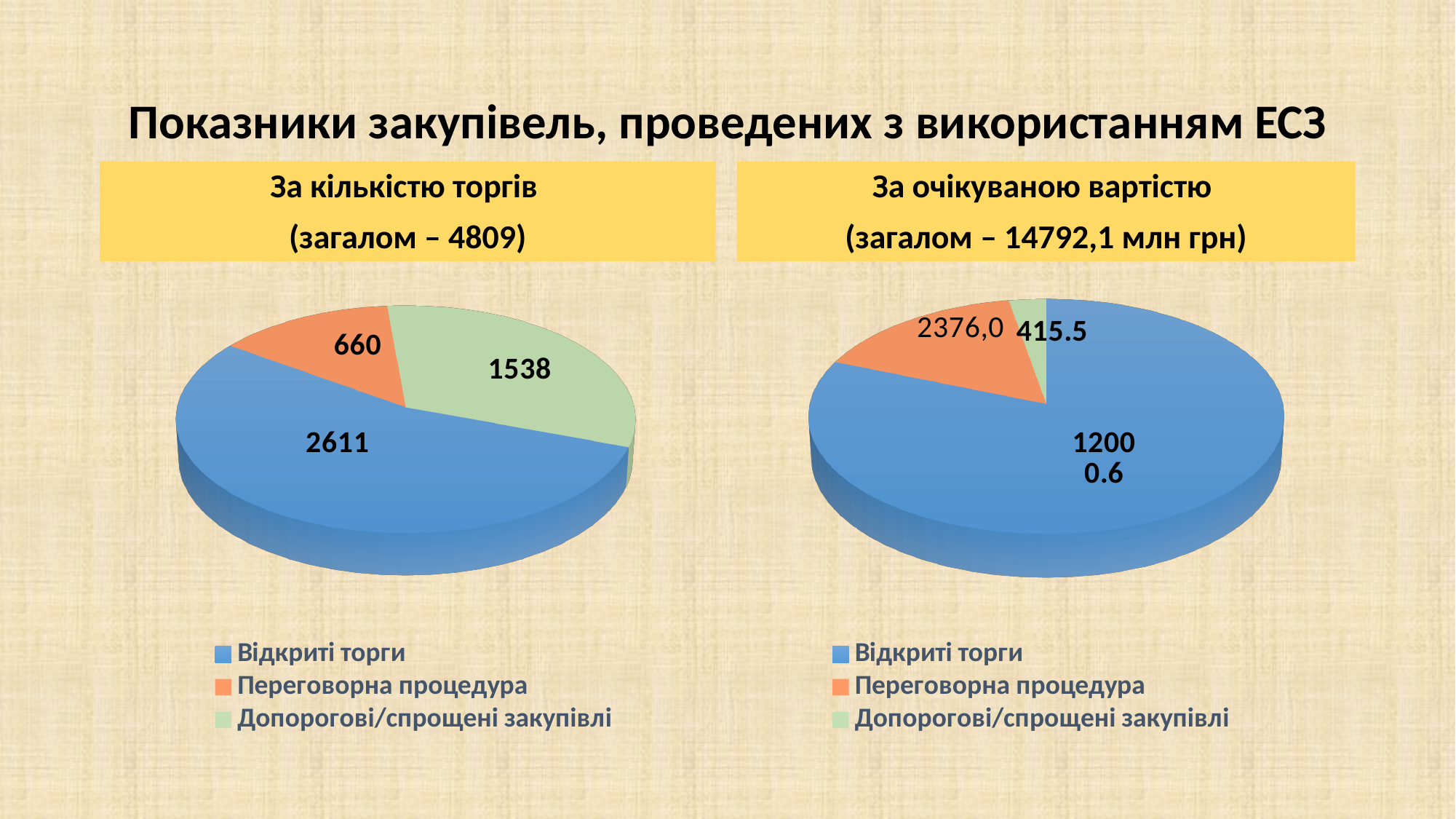
In the left chart 'За кількістю торгів', which category has the smallest slice? Переговорна процедура In the left chart 'За кількістю торгів', what is the value for 'Переговорна процедура'? 660 In the left chart 'За кількістю торгів', which category has the largest slice? Відкриті торги In the right chart 'За очікуваною вартістю', which category has the largest slice? Відкриті торги In the right chart 'За очікуваною вартістю', what is the value for 'Допорогові/спрощені закупівлі'? 415.5 In the left chart 'За кількістю торгів', what is the difference between 'Відкриті торги' and 'Допорогові/спрощені закупівлі'? 1073 In the right chart 'За очікуваною вартістю', which is larger: 'Переговорна процедура' or 'Допорогові/спрощені закупівлі'? Переговорна процедура In the right chart 'За очікуваною вартістю', what is the value for 'Переговорна процедура'? 2376,0 In the left chart 'За кількістю торгів', what is the value for 'Допорогові/спрощені закупівлі'? 1538 What kind of chart is the left chart, 'За кількістю торгів'? Pie chart How many slices does the left chart 'За кількістю торгів' have? 3 In the left chart 'За кількістю торгів', what is the value for 'Відкриті торги'? 2611